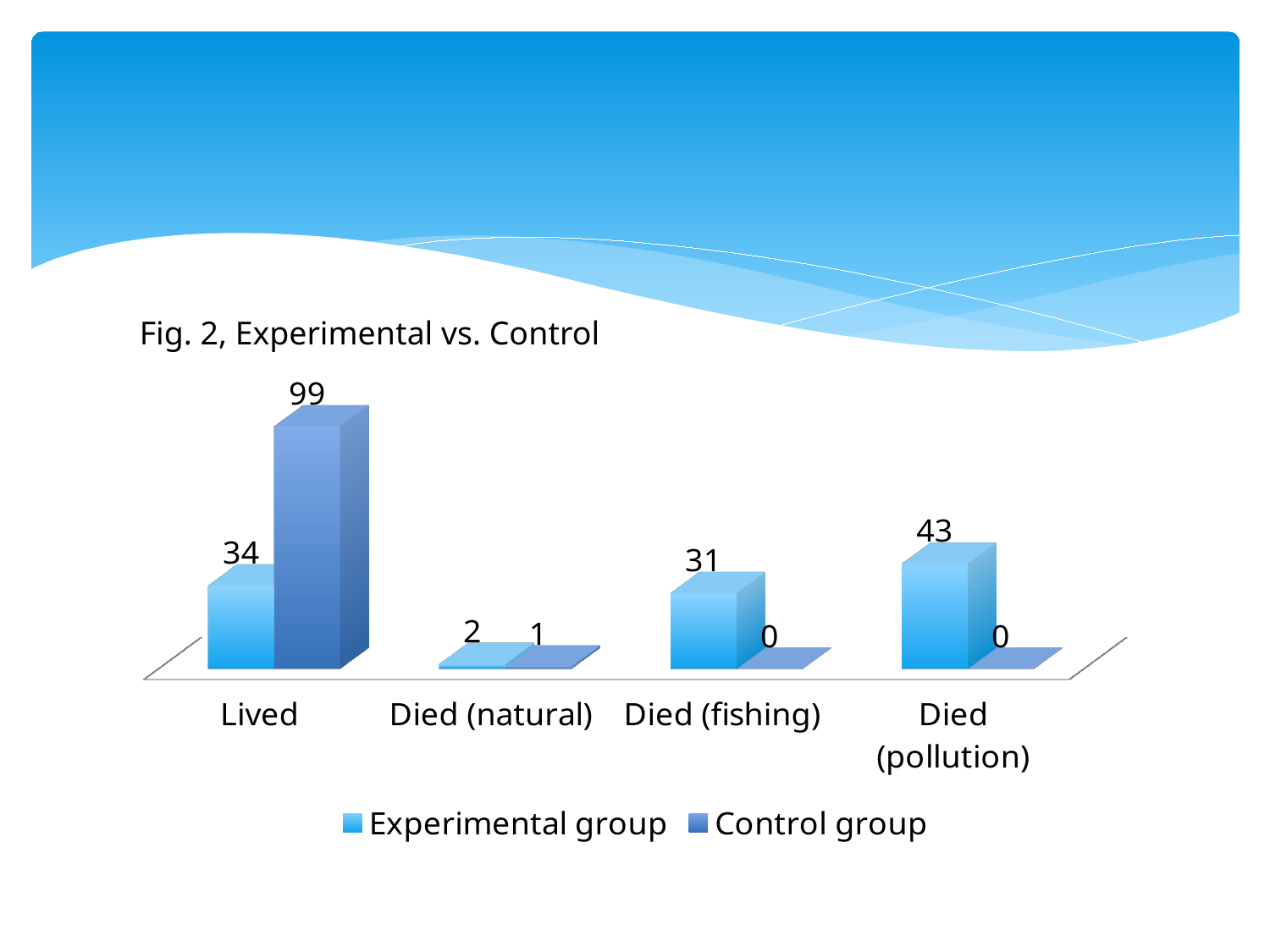
Which is larger in the Died (natural) category: the Experimental group or the Control group? Experimental group What is the value for the Experimental group in the Died (pollution) category? 43 How many categories are shown on the x axis? 4 Which category has the lowest value for the Experimental group? Died (natural) What is the value for the Control group in the Lived category? 99 What is the value for the Control group in the Died (fishing) category? 0 What kind of chart is shown on the slide? Bar chart What is the value for the Experimental group in the Lived category? 34 What is the title of the chart? Fig. 2, Experimental vs. Control How many series does the legend list? 2 Which category has the highest value for the Experimental group? Died (pollution) What is the difference between the Control group and Experimental group values in the Lived category? 65